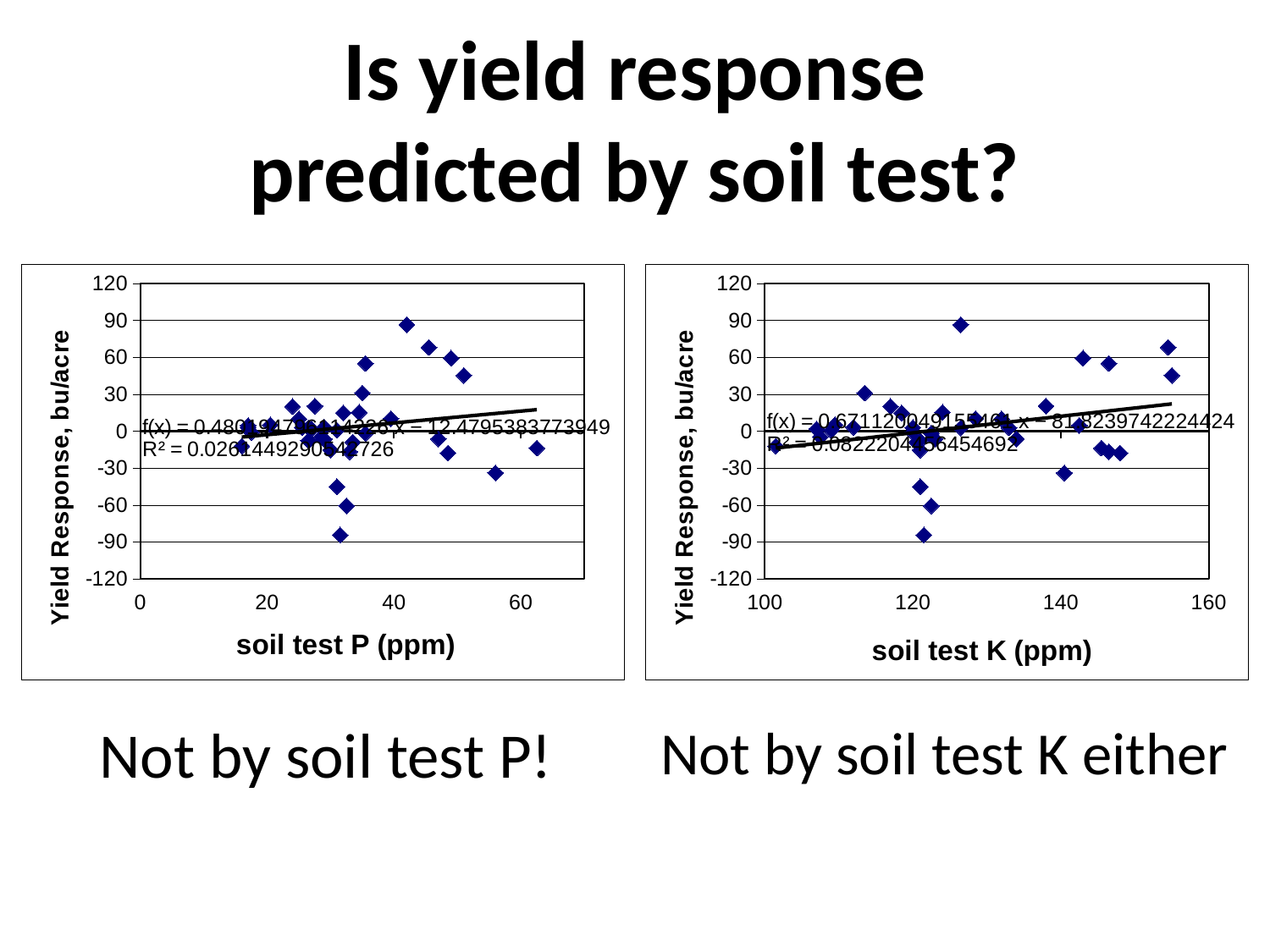
In the left chart (soil test P), does the fitted trend line rise or fall as soil test P increases? rise In the left chart (soil test P), is the highest plotted yield response greater or less than 60? greater What kind of chart is the right chart (soil test K)? scatter chart In the right chart (soil test K), is the highest plotted yield response greater or less than 60? greater In the right chart (soil test K), is the lowest plotted yield response greater or less than -60? less In the right chart (soil test K), does the fitted trend line rise or fall as soil test K increases? rise What kind of chart is the left chart (soil test P)? scatter chart In the left chart, what is the title of the x axis? soil test P (ppm) In the right chart, what is the title of the y axis? Yield Response, bu/acre